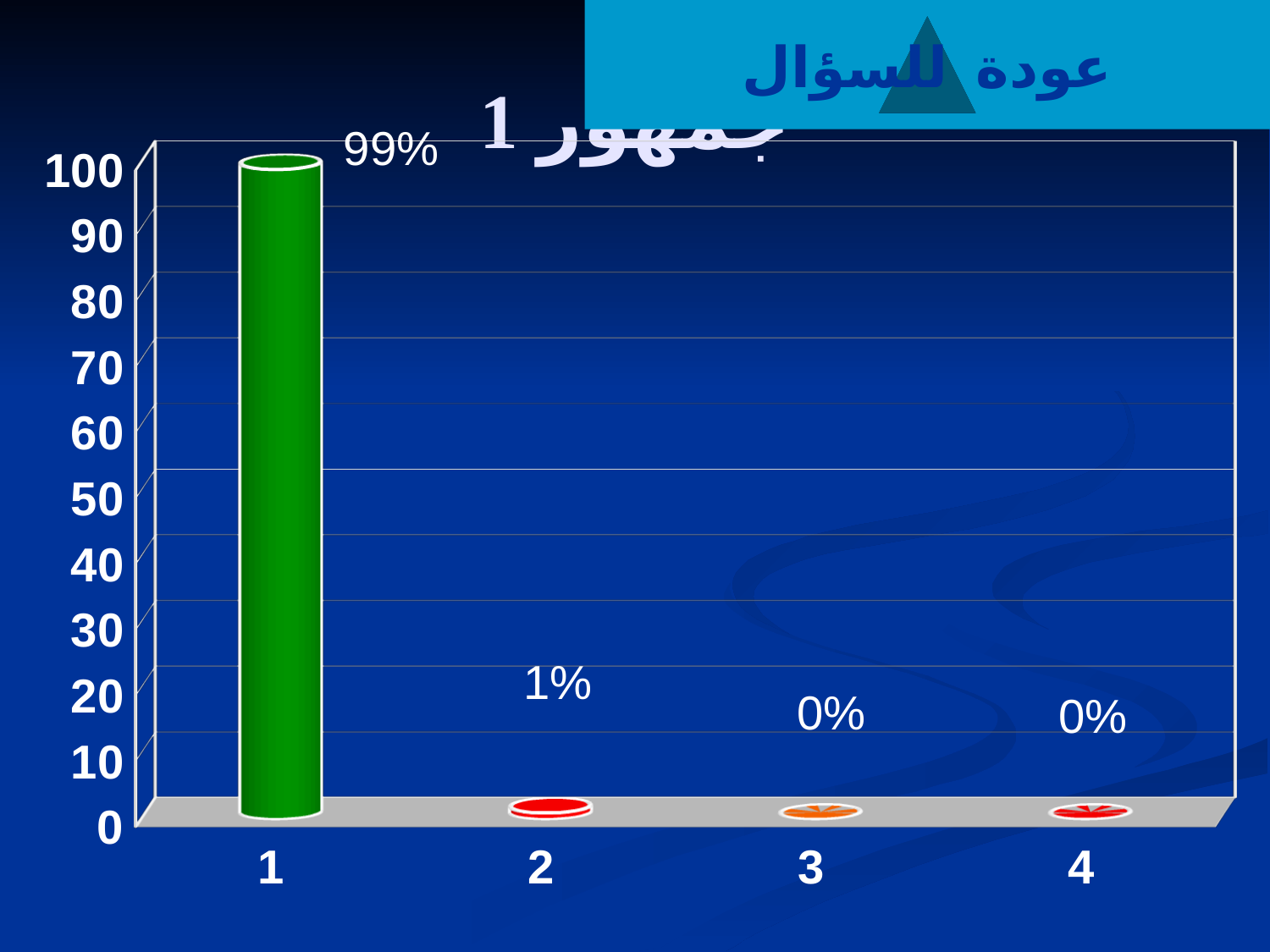
Is the value for category 1 greater or less than 50? greater What is the value for category 4? 0% What kind of chart is shown on the slide? bar chart Which is larger, the value for category 1 or the value for category 2? category 1 Which category has the highest value? 1 What is the value for category 2? 1% How many categories are shown on the x axis? 4 What is the value for category 3? 0% What is the difference between the values for category 1 and category 2? 98% What is the value for category 1? 99% Is the value for category 2 greater or less than 10? less What colour is the bar for category 1? green